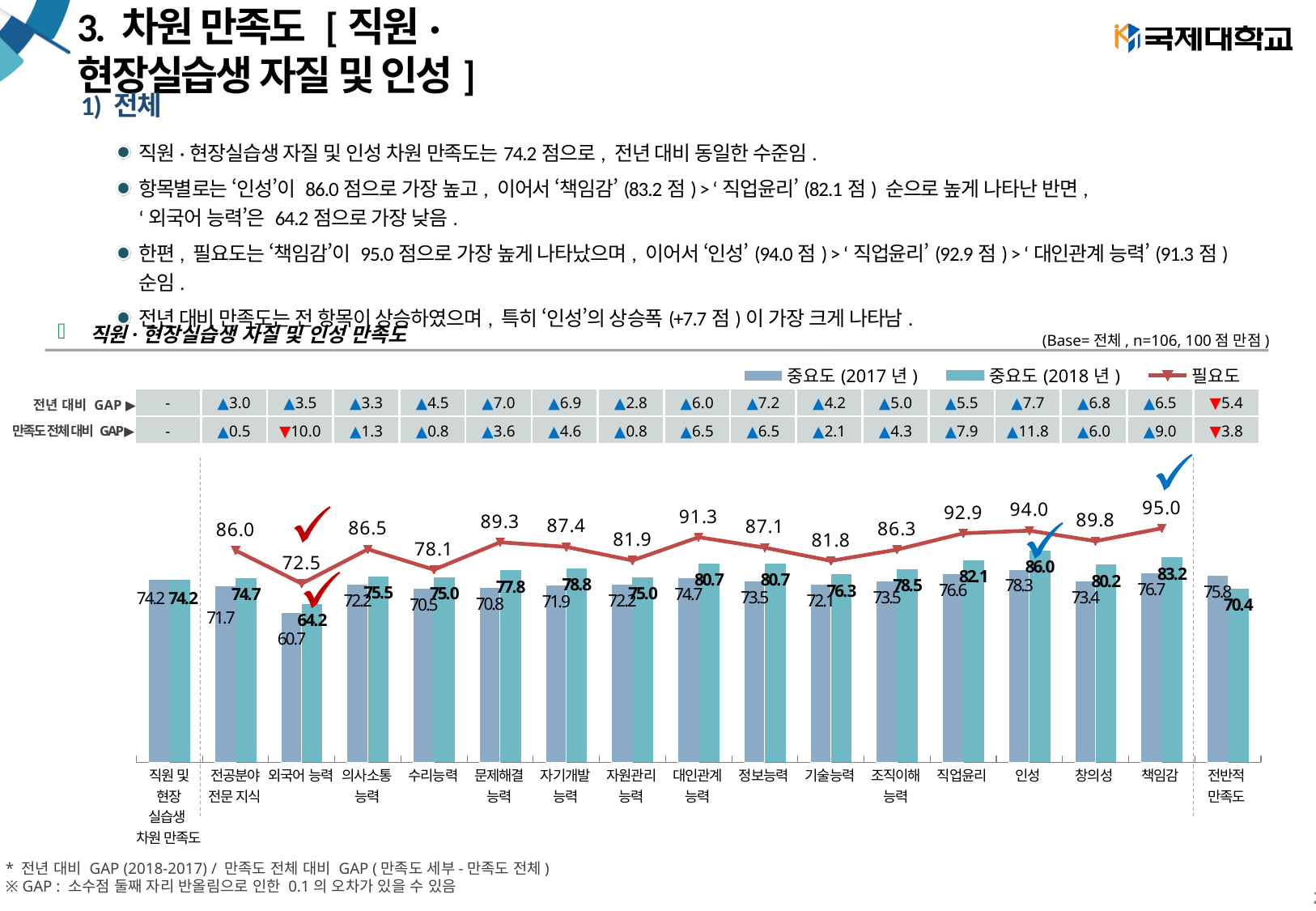
What is the 필요도 value for 외국어 능력? 72.5 How many series does the legend list? 3 What is the difference between the 필요도 values for 책임감 and 인성? 1.0 What kind of chart is shown? Combined bar and line chart Which is larger for 전반적 만족도: the 2017 중요도 value or the 2018 중요도 value? 2017 중요도 (75.8) What is the 2018 중요도 value for 직업윤리? 82.1 What is the 필요도 value for 책임감? 95.0 Which category has the highest 필요도 value? 책임감 What is the 2018 중요도 value for 인성? 86.0 Which category has the lowest 2018 중요도 value? 외국어 능력 What is the 2017 중요도 value for 외국어 능력? 60.7 What is the difference between the 2018 and 2017 중요도 values for 인성? 7.7